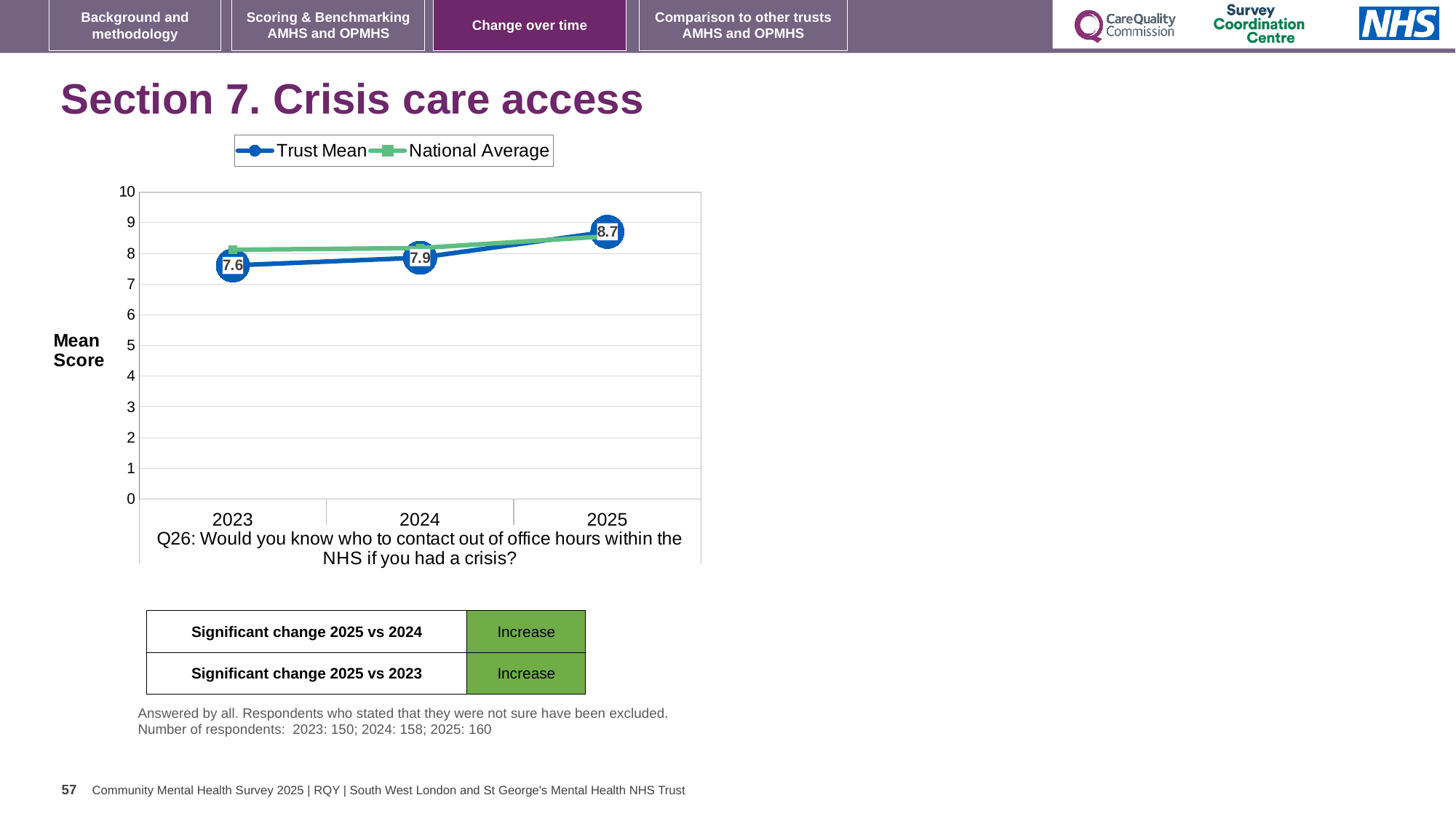
Does the Trust Mean rise or fall from 2023 to 2025? rise What is the difference between the Trust Mean score in 2025 and in 2023? 1.1 What is the Trust Mean score for 2023? 7.6 In 2023, which is larger: the Trust Mean or the National Average? National Average How many series does the chart legend list? 2 In which year is the Trust Mean score lowest? 2023 What is the Trust Mean score for 2025? 8.7 In which year is the Trust Mean score highest? 2025 How many years are shown on the x axis of the chart? 3 Is the National Average value for 2025 greater or less than 9? less What is the difference between the Trust Mean score in 2025 and in 2024? 0.8 What is the Trust Mean score for 2024? 7.9